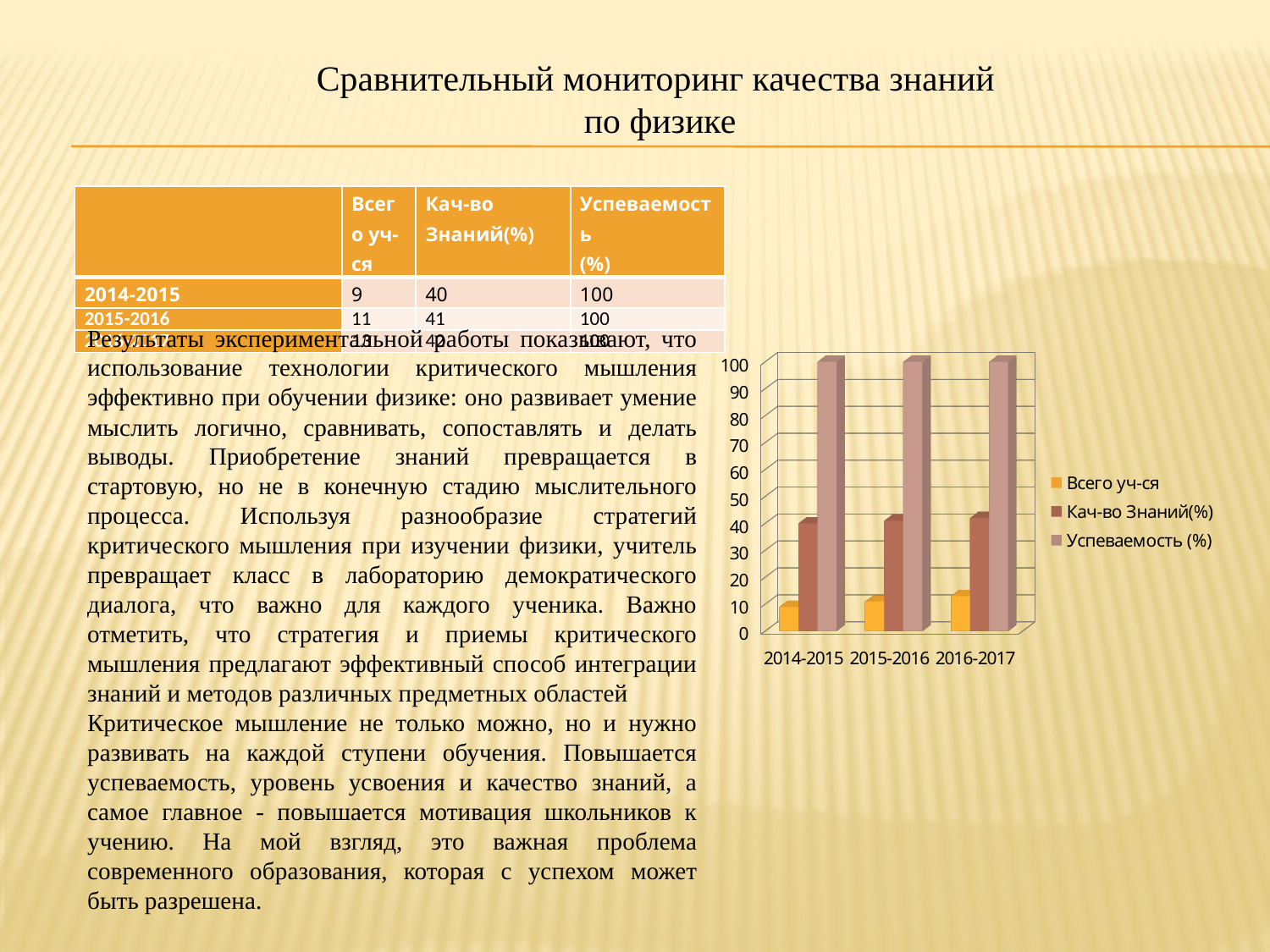
Which series has the highest value in 2014-2015? Успеваемость (%) Is the value for Кач-во Знаний(%) in 2015-2016 greater or less than 30? greater Is the value for Кач-во Знаний(%) in 2014-2015 greater or less than 50? less Do the values for Всего уч-ся rise or fall from 2014-2015 to 2016-2017? rise How many series does the chart legend list? 3 How many categories (school years) are shown on the x axis of the chart? 3 Is the value for Всего уч-ся in 2014-2015 greater or less than 20? less Which series has the lowest value in 2015-2016? Всего уч-ся Which series is listed first in the chart legend? Всего уч-ся What is the value of Успеваемость (%) for 2014-2015 in the chart? 100 In 2016-2017, which is larger: Кач-во Знаний(%) or Всего уч-ся? Кач-во Знаний(%) What kind of chart is shown on the slide? bar chart